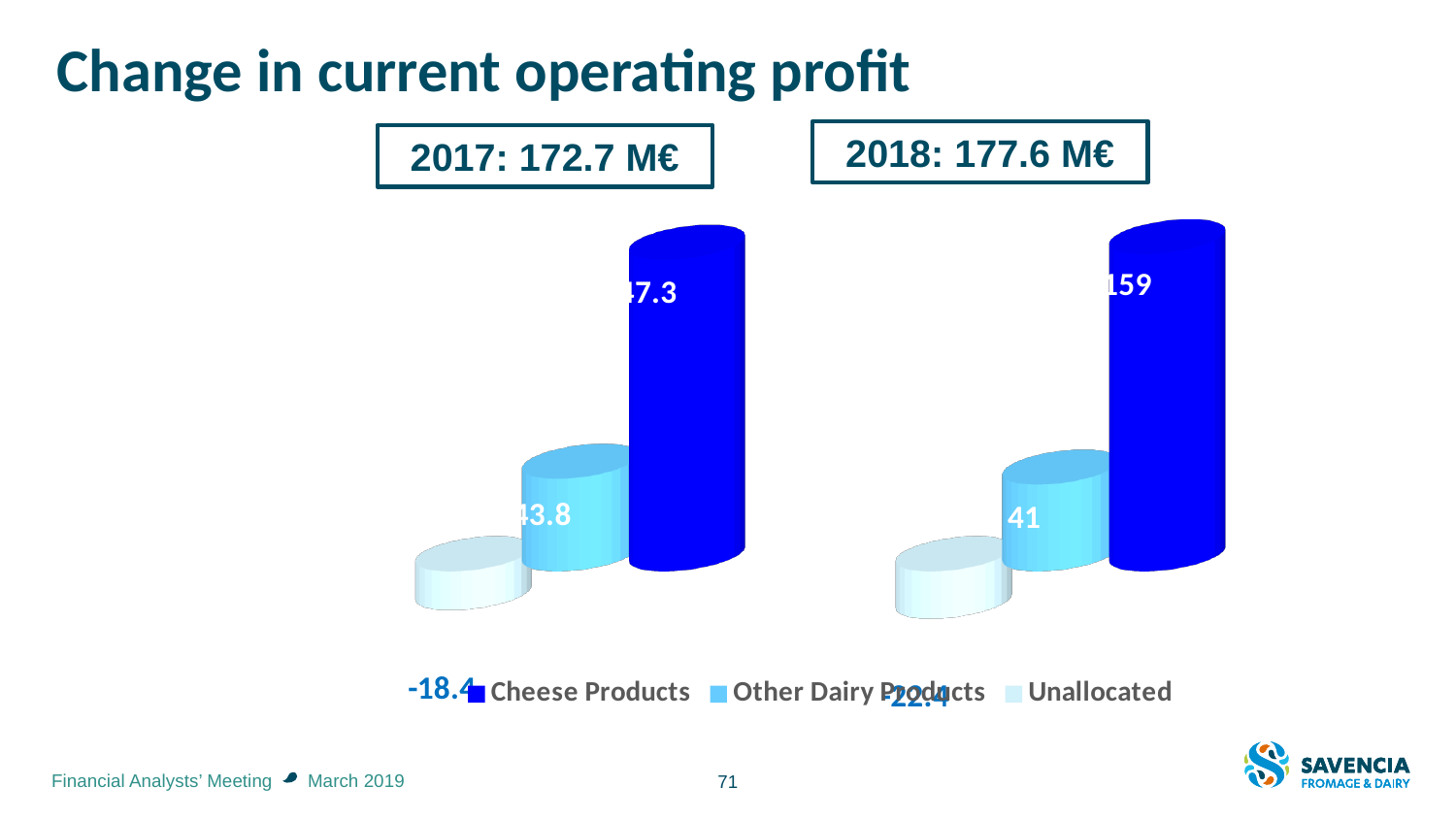
How many series does the legend list? 3 Which series has the highest value in 2018? Cheese Products What is the difference between the Other Dairy Products values for 2017 and 2018? 2.8 What is the value for Unallocated in 2017? -18.4 Which year has the larger value for Other Dairy Products, 2017 or 2018? 2017 What is the value for Other Dairy Products in 2017? 43.8 What is the value for Other Dairy Products in 2018? 41 How many year groups are plotted in the chart? 2 What kind of chart is shown on the slide? bar chart What is the title of the chart? Change in current operating profit What is the value for Cheese Products in 2018? 159 What is the total current operating profit shown for 2018? 177.6 M€